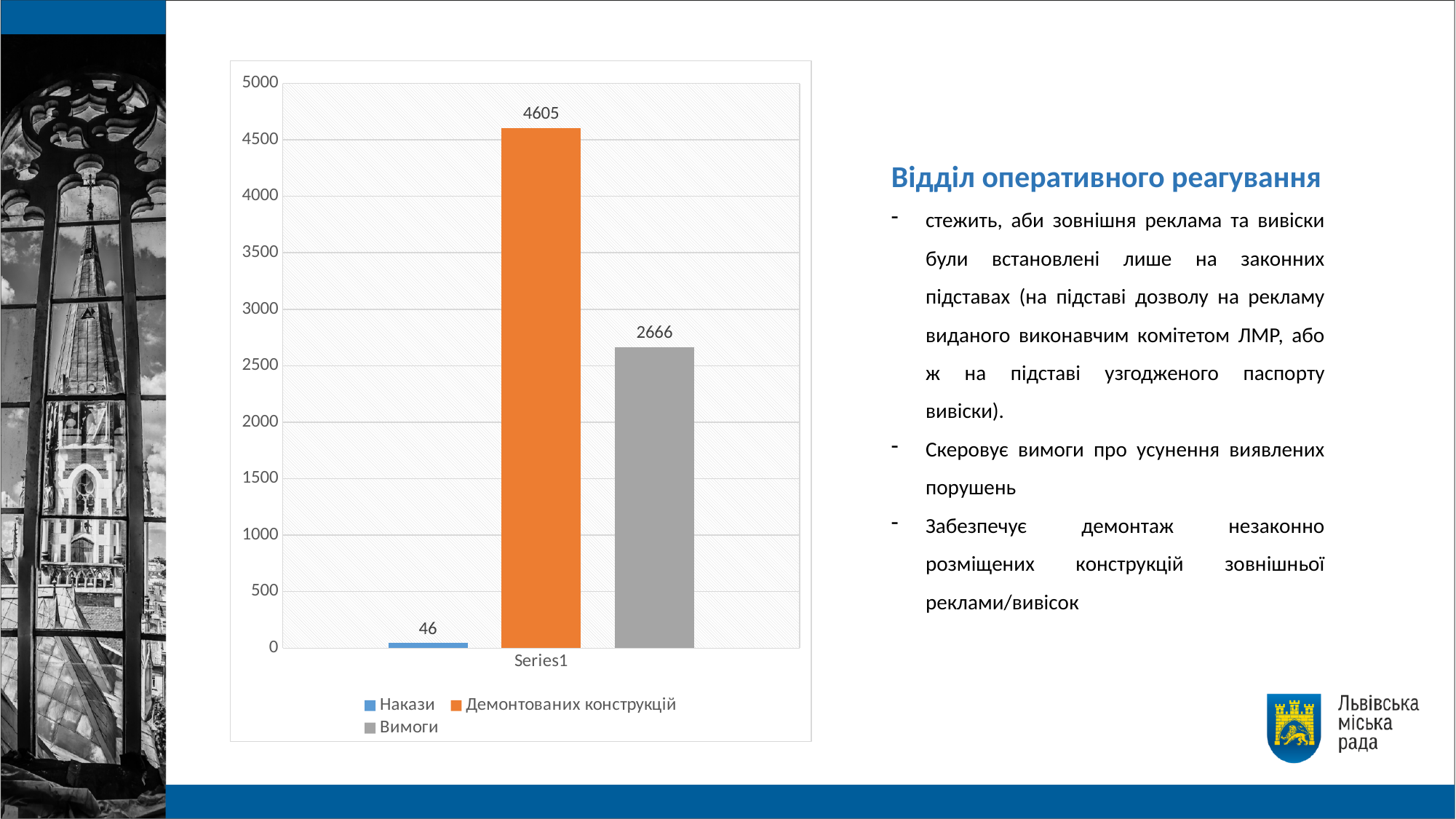
What is the difference between Демонтованих конструкцій and Вимоги? 1939 What is the value for Вимоги? 2666 What is the value for Демонтованих конструкцій? 4605 What is the difference between Вимоги and Накази? 2620 Which series has the highest value? Демонтованих конструкцій How many series does the legend list? 3 Is the value for Вимоги greater or less than 3000? less Which is larger, Вимоги or Накази? Вимоги What is the value for Накази? 46 What colour is the bar for Демонтованих конструкцій? orange Which series has the lowest value? Накази What kind of chart is shown on the slide? bar chart